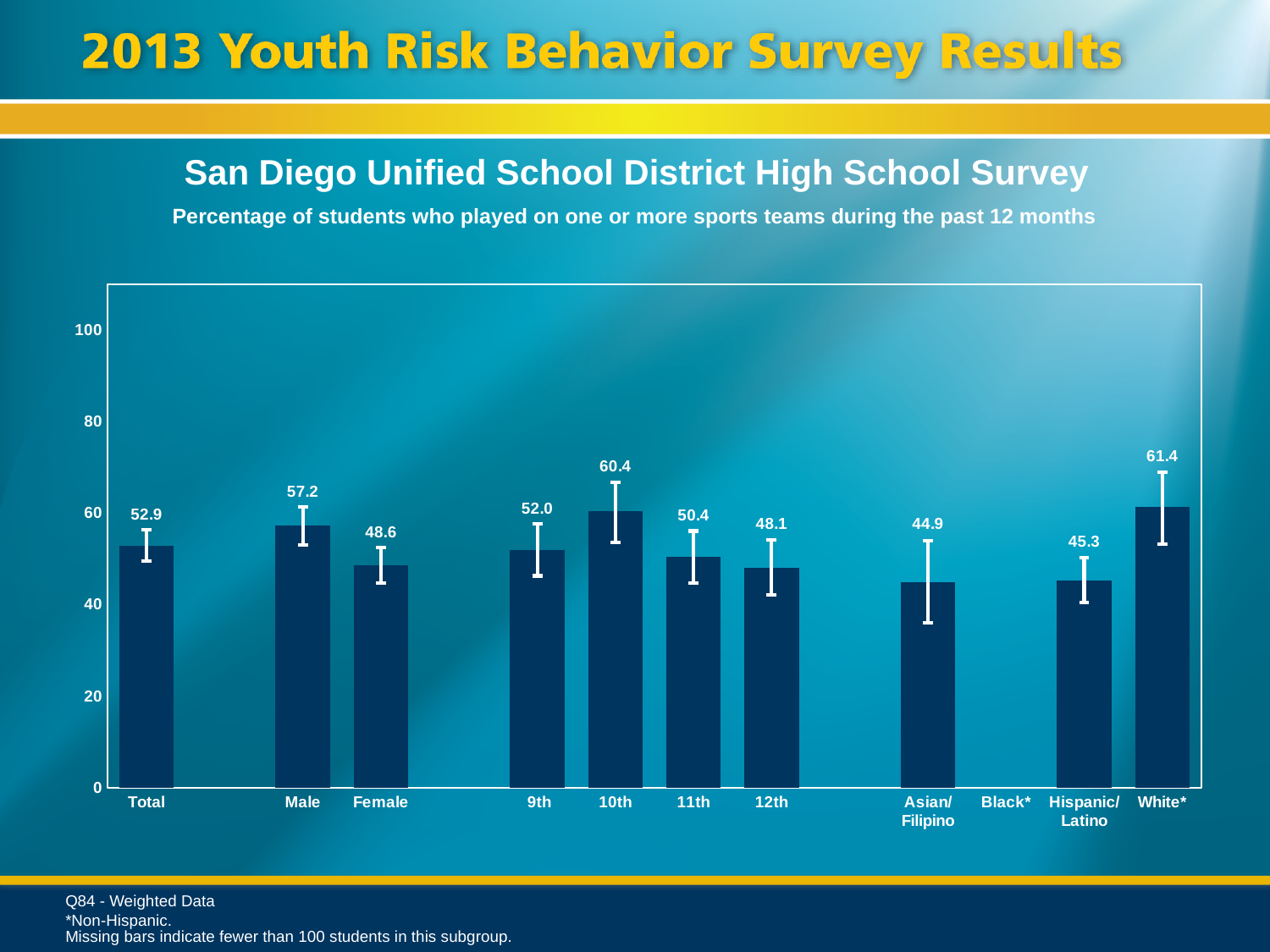
How many categories have a bar plotted? 10 What is the value for 10th grade students? 60.4 Which category with a bar has the lowest value? Asian/Filipino Which category label has no bar plotted? Black* What kind of chart is shown? bar chart What percentage of students in total played on one or more sports teams during the past 12 months? 52.9 Is the value for Female students greater or less than 40? greater What is the value for Male students? 57.2 What is the difference between the Male and Female values? 8.6 Which is larger, the value for 9th grade or the value for 12th grade? 9th What is the value for Hispanic/Latino students? 45.3 Which category has the highest value? White*